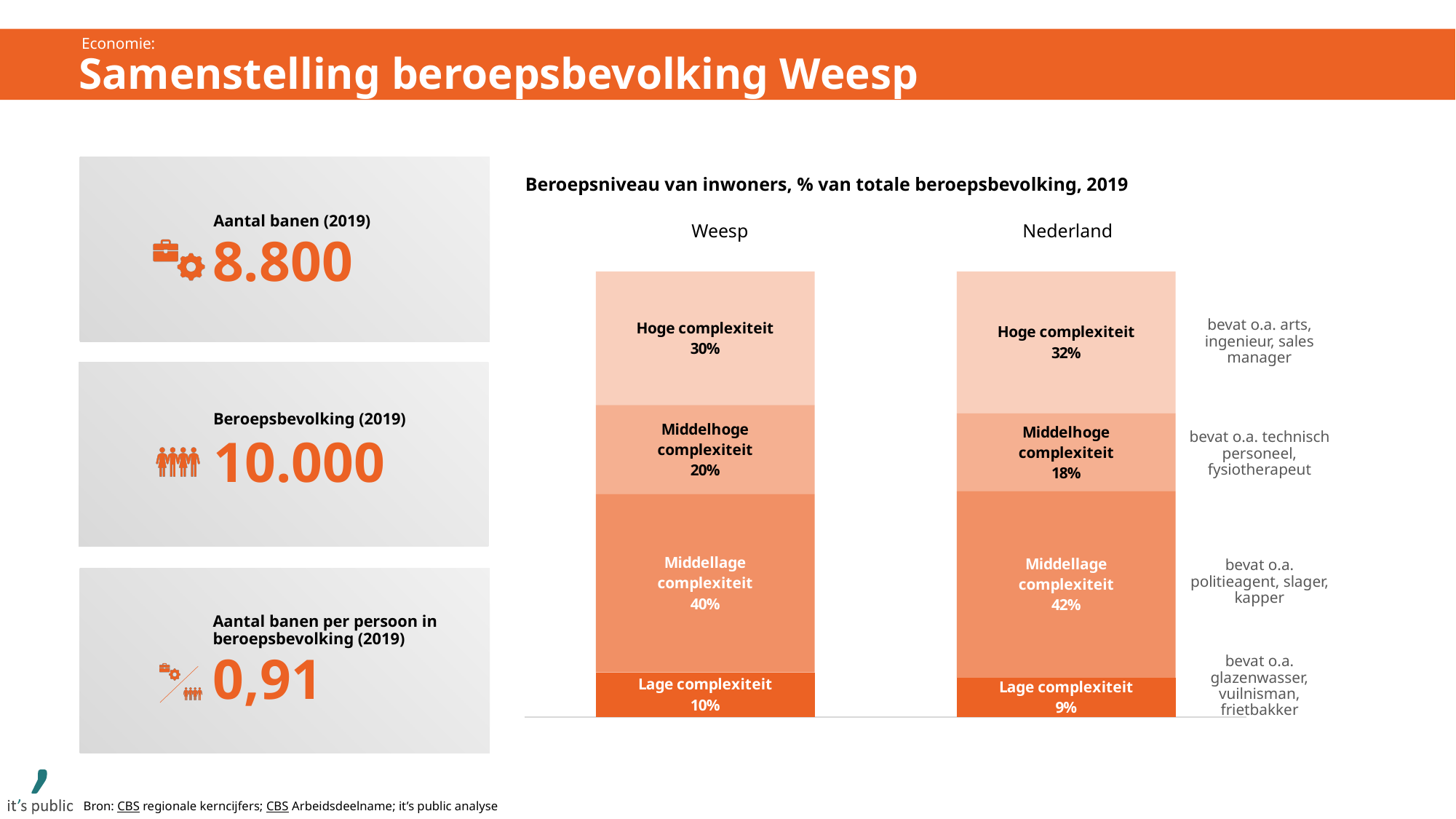
In the chart, which complexity level has the largest share for Weesp? Middellage complexiteit In the chart, which complexity level has the smallest share for Nederland? Lage complexiteit In the chart, what is the share of 'Middelhoge complexiteit' for Weesp? 20% In the chart, what is the difference between the 'Middellage complexiteit' shares of Nederland and Weesp? 2% In the chart, what is the share of 'Hoge complexiteit' for Weesp? 30% How many stacked bars does the chart show? 2 In the chart, which has a larger 'Middelhoge complexiteit' share, Weesp or Nederland? Weesp What kind of chart is shown under 'Beroepsniveau van inwoners, % van totale beroepsbevolking, 2019'? Stacked bar chart In the chart, what is the share of 'Middellage complexiteit' for Nederland? 42% In the chart, what is the share of 'Lage complexiteit' for Nederland? 9% How many segments does each stacked bar in the chart contain? 4 In the chart, what is the total of the four segments of the Weesp bar? 100%